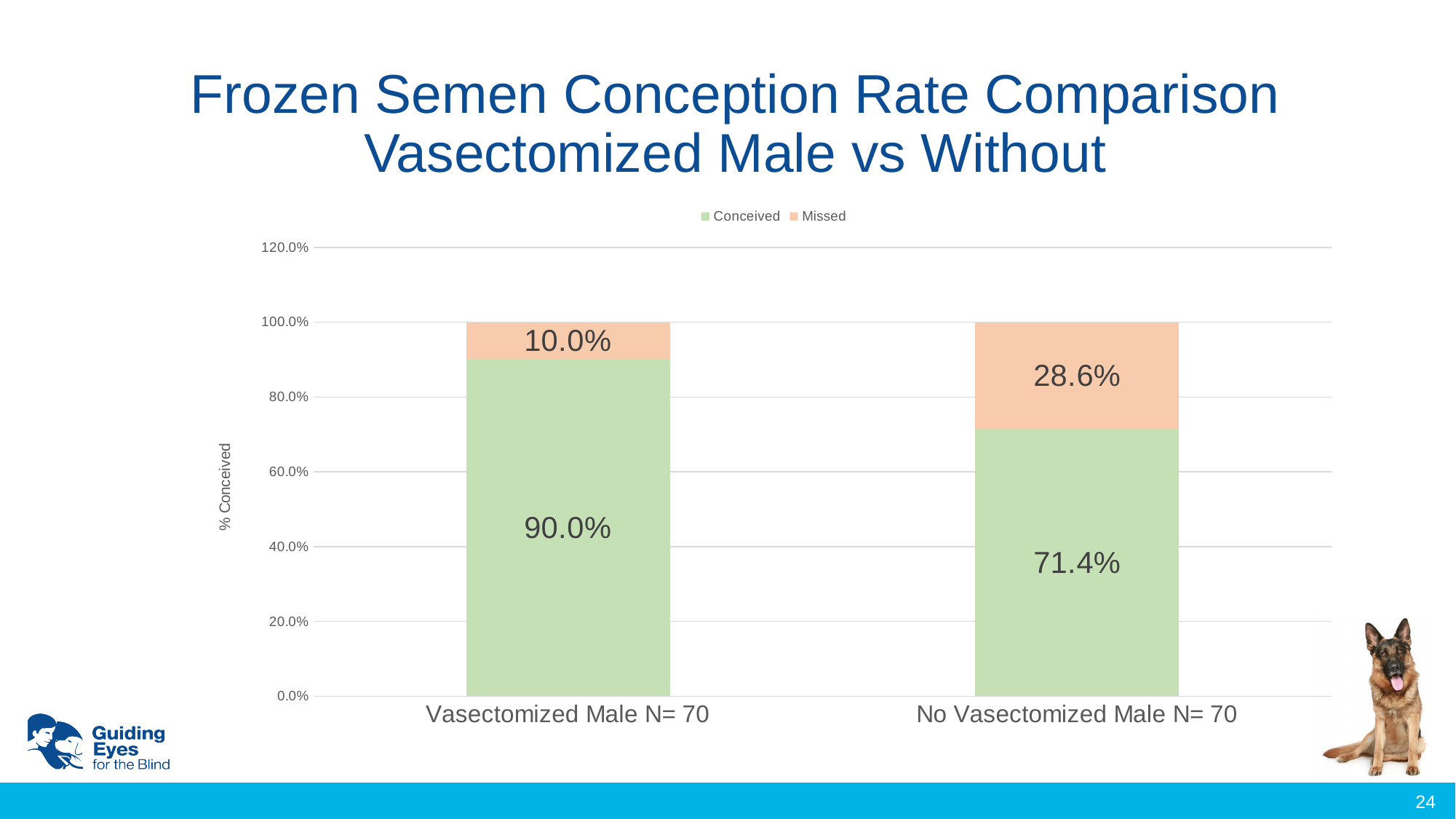
What is the difference between the Conceived values for Vasectomized Male N= 70 and No Vasectomized Male N= 70? 18.6% What is the Missed value for Vasectomized Male N= 70? 10.0% Which category has the highest Conceived value? Vasectomized Male N= 70 What is the Missed value for No Vasectomized Male N= 70? 28.6% Is the Missed value larger for Vasectomized Male N= 70 or No Vasectomized Male N= 70? No Vasectomized Male N= 70 What kind of chart is shown on the slide? Stacked bar chart What is the Conceived value for Vasectomized Male N= 70? 90.0% What is the total of the stacked bar for No Vasectomized Male N= 70? 100.0% What is the Conceived value for No Vasectomized Male N= 70? 71.4% How many categories are shown on the x axis? 2 Which category has the lowest Missed value? Vasectomized Male N= 70 How many series does the legend list? 2